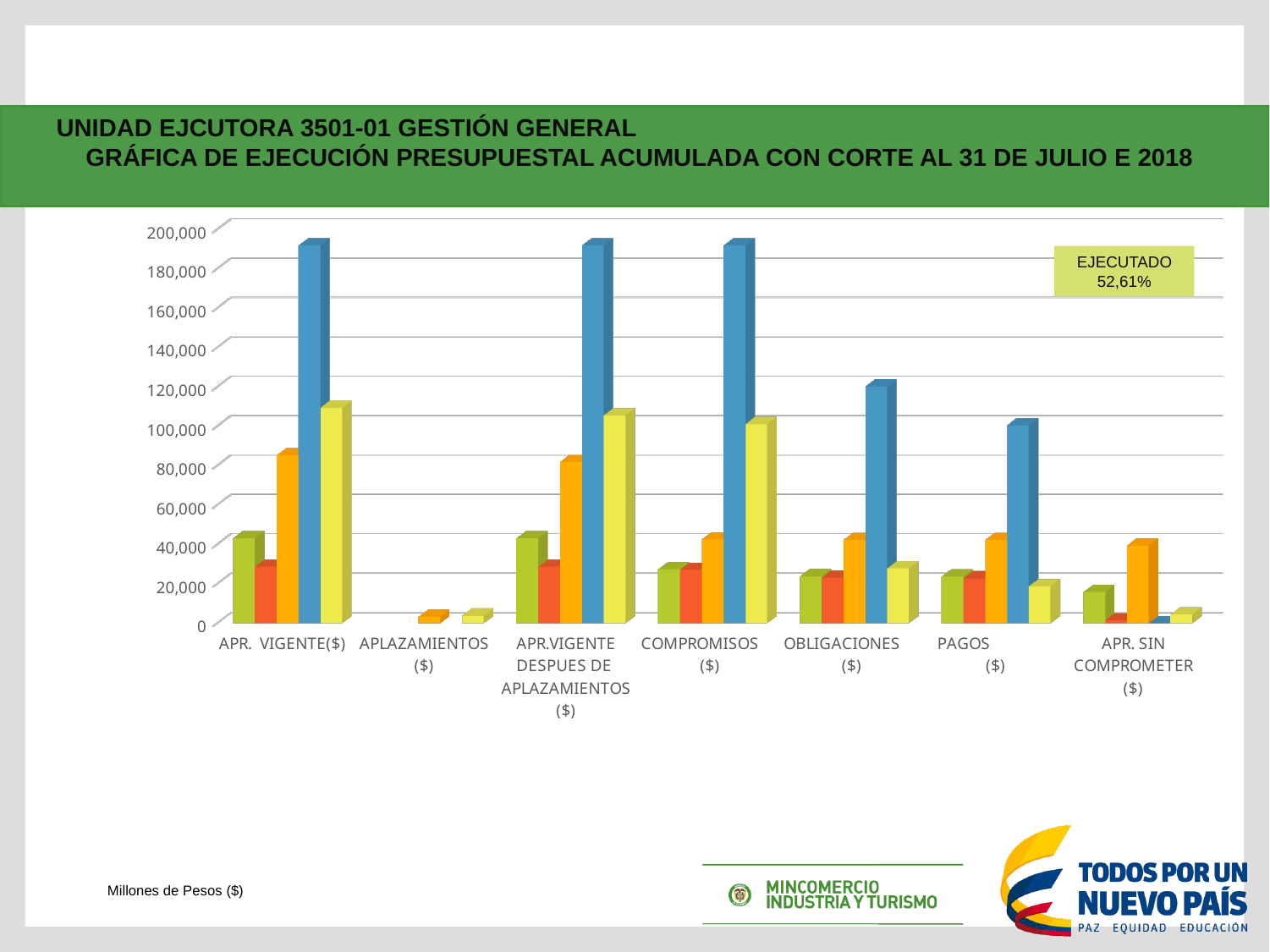
How many categories are shown along the x axis of the chart? 7 Which is larger: the blue bar for APR. VIGENTE($) or the blue bar for OBLIGACIONES ($)? APR. VIGENTE($) Is the value of the orange bar for APR. SIN COMPROMETER ($) greater or less than 20,000? greater Is the value of the blue bar for COMPROMISOS ($) greater or less than 180,000? greater Which category has the shortest blue bar? APR. SIN COMPROMETER ($) Is the value of the blue bar for APR. VIGENTE($) greater or less than 180,000? greater Which category has the lowest values overall across all its bars? APLAZAMIENTOS ($) What percentage is shown in the EJECUTADO box on the chart? 52,61% What kind of chart is shown on the slide? bar chart What unit is stated for the values in the chart, according to the note at the bottom left of the slide? Millones de Pesos ($)